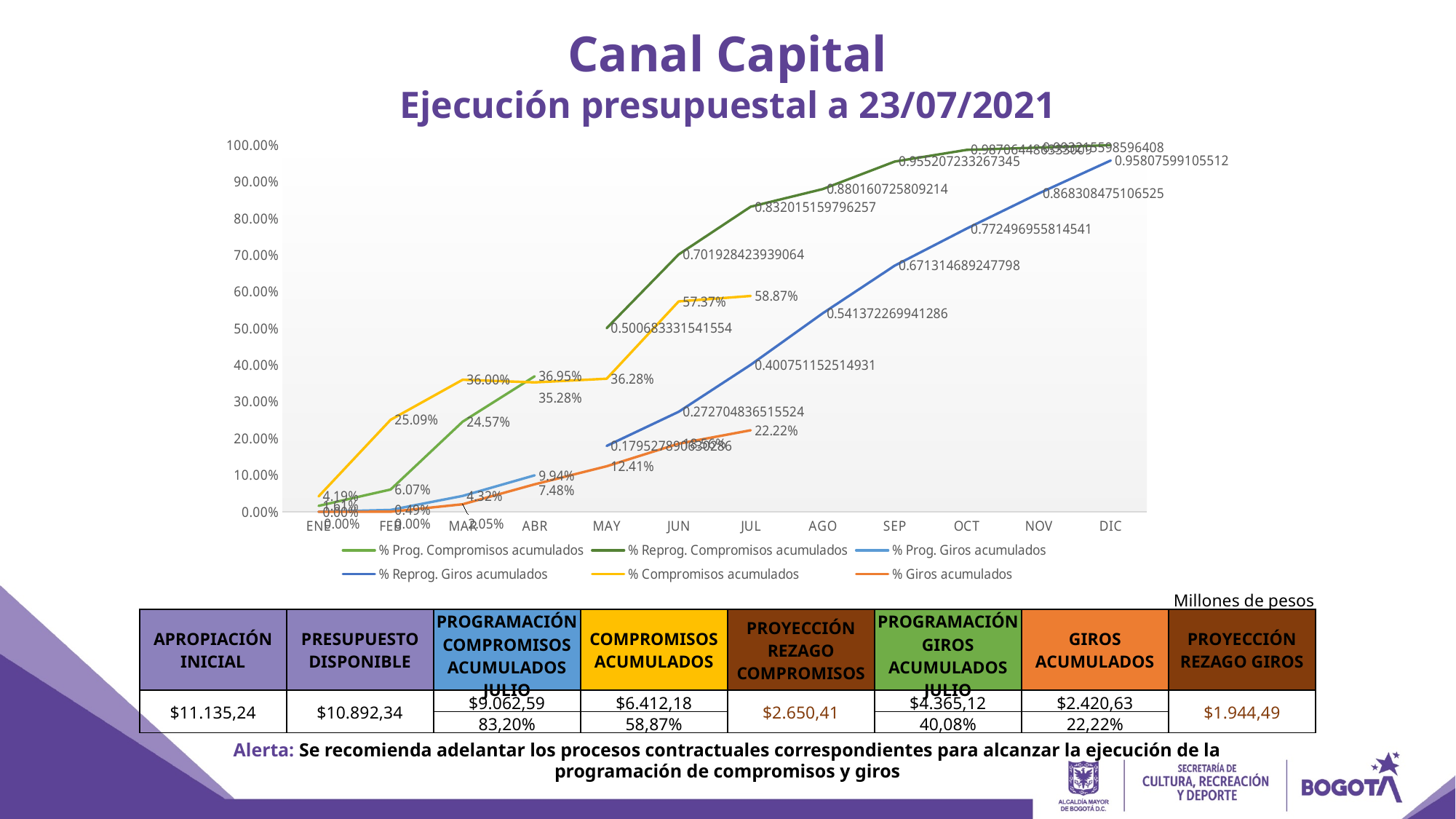
What is the value of % Compromisos acumulados in JUL? 58.87% Does % Reprog. Giros acumulados rise or fall from MAY to DIC? Rise In JUL, which is larger: % Compromisos acumulados or % Giros acumulados? % Compromisos acumulados What is the value of % Reprog. Compromisos acumulados in JUN? 0.701928423939064 How many months are shown on the x axis of the chart? 12 What kind of chart is shown on the slide? Line chart Is the value of % Reprog. Compromisos acumulados in SEP greater or less than 90.00%? greater What is the value of % Reprog. Giros acumulados in DIC? 0.95807599105512 What is the value of % Compromisos acumulados in FEB? 25.09% What is the difference between % Compromisos acumulados in JUL and in JUN? 1.50% How many series does the chart legend list? 6 What is the value of % Giros acumulados in JUL? 22.22%